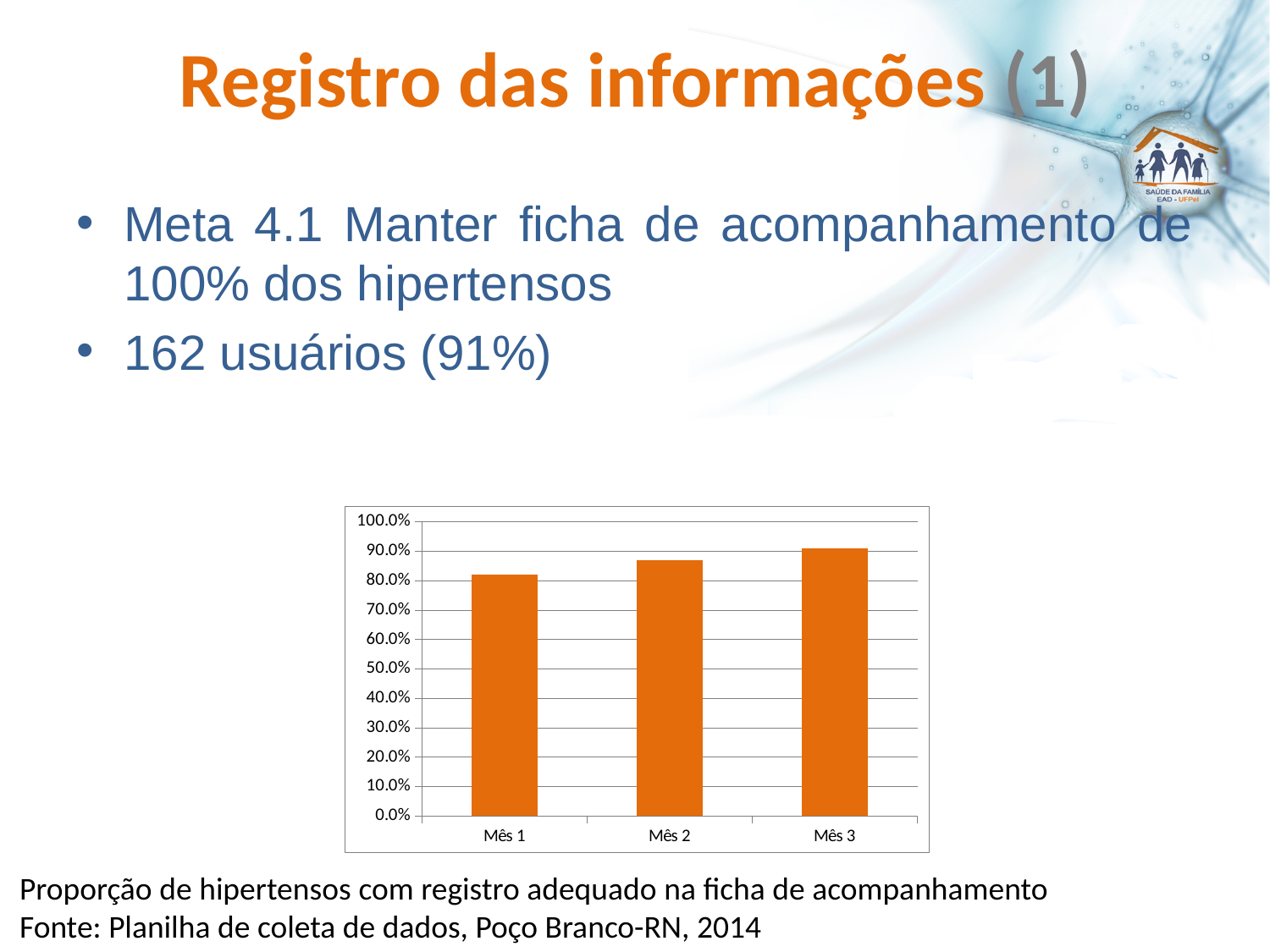
Is the value for Mês 1 greater or less than 90.0%? less Is the value for Mês 2 greater or less than 90.0%? less What kind of chart is shown on the slide? bar chart Which month has the lowest bar on the chart? Mês 1 Is the value for Mês 1 greater or less than 70.0%? greater How many categories (months) are plotted on the chart? 3 Which month has the highest bar on the chart? Mês 3 What colour are the bars in the chart? orange Do the values rise or fall from Mês 1 to Mês 3? rise Which is larger, the value for Mês 1 or the value for Mês 3? Mês 3